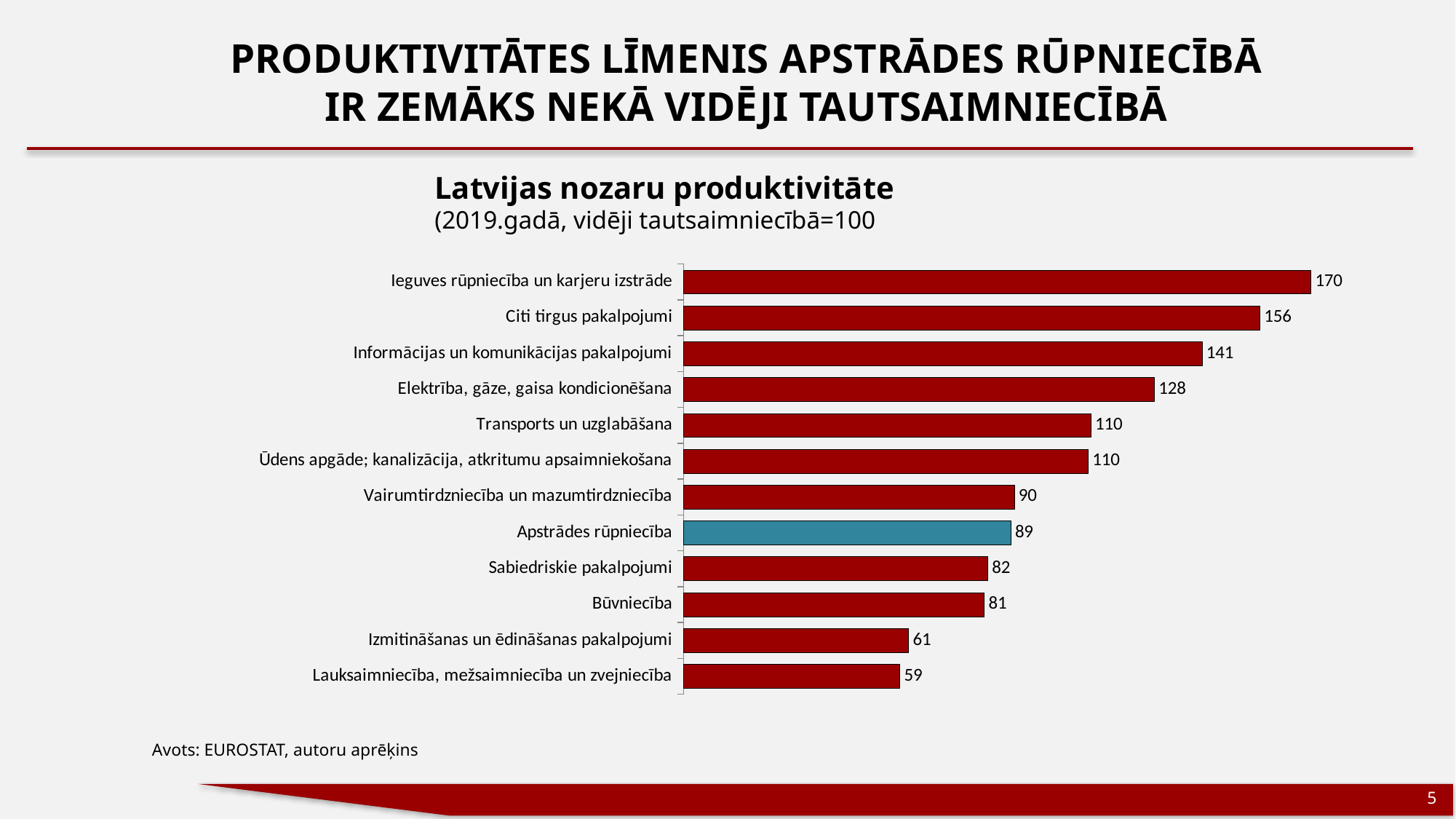
What is the difference between the values for Ieguves rūpniecība un karjeru izstrāde and Apstrādes rūpniecība? 81 What is the value for Apstrādes rūpniecība? 89 What kind of chart is shown on the slide? Bar chart What is the title of the chart? Latvijas nozaru produktivitāte Which category has the highest value? Ieguves rūpniecība un karjeru izstrāde What is the value for Informācijas un komunikācijas pakalpojumi? 141 Which category's bar is coloured differently (blue) from the others? Apstrādes rūpniecība Which category has the lowest value? Lauksaimniecība, mežsaimniecība un zvejniecība How many categories are shown in the chart? 12 What is the value for Būvniecība? 81 Which is larger, the value for Sabiedriskie pakalpojumi or the value for Izmitināšanas un ēdināšanas pakalpojumi? Sabiedriskie pakalpojumi What is the difference between the values for Citi tirgus pakalpojumi and Elektrība, gāze, gaisa kondicionēšana? 28